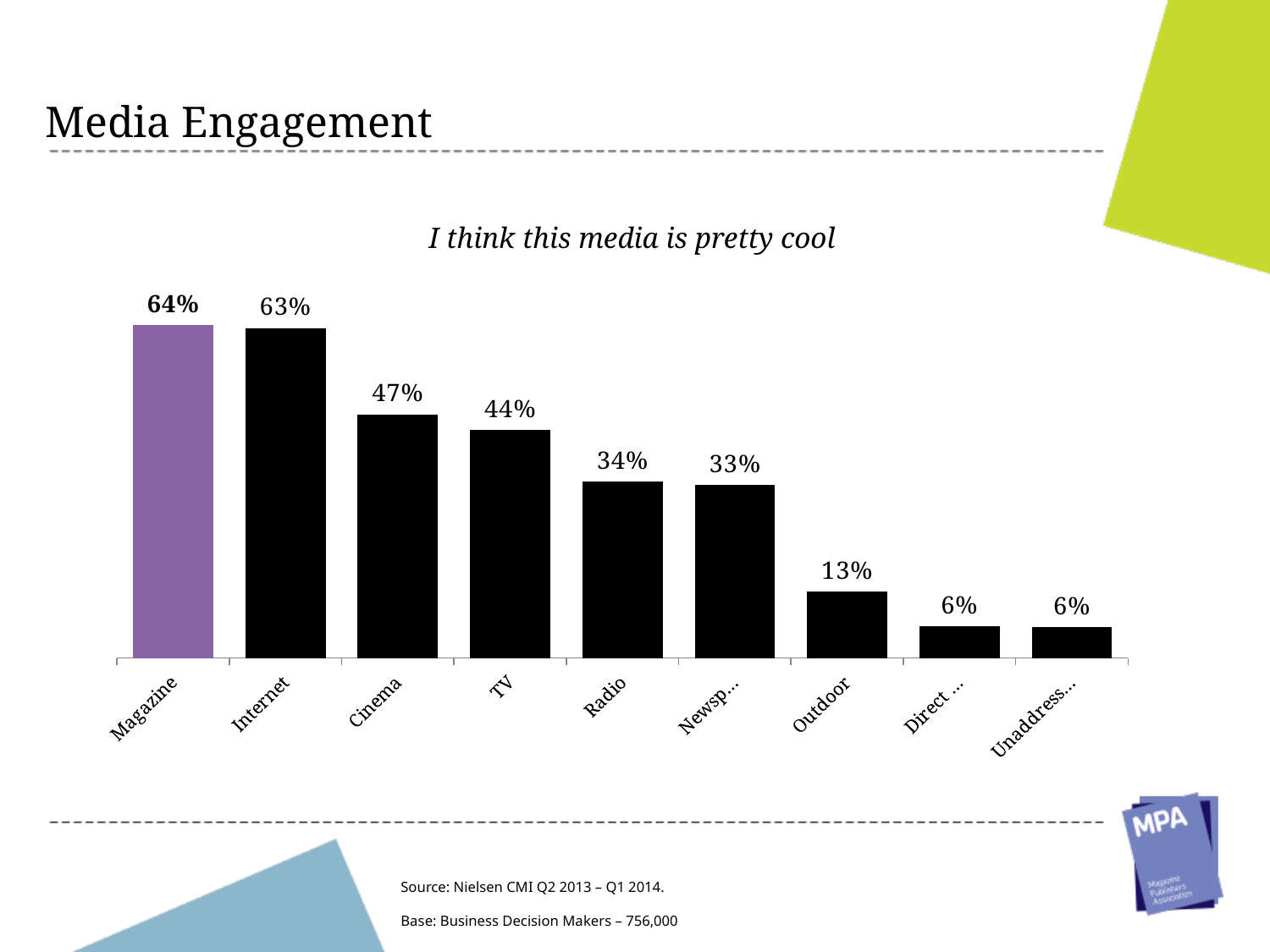
What is the difference between the values for Magazine and Outdoor? 51% How many categories are plotted in the chart? 9 What kind of chart is shown on the slide? Bar chart What is the value for Internet? 63% Which category has the highest value? Magazine What is the value for Outdoor? 13% Do the values rise or fall from left to right along the x axis? Fall What is the value for Magazine? 64% Which is larger, the value for Cinema or the value for Radio? Cinema What is the value for TV? 44% What is the value for Cinema? 47% What is the value for Radio? 34%